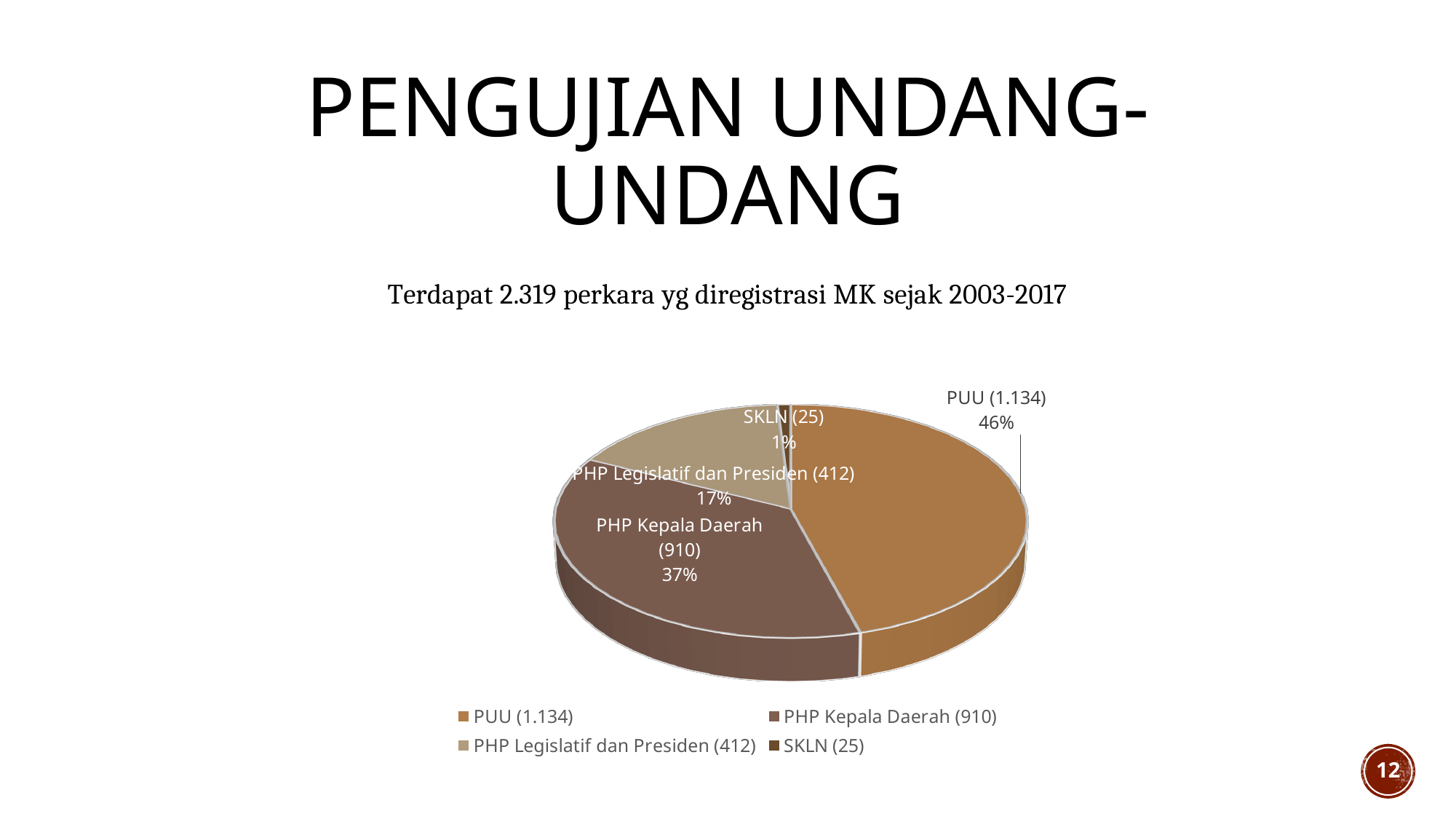
What is the difference in percentage points between the PUU (1.134) share and the PHP Kepala Daerah (910) share? 9% What percentage share does the PHP Legislatif dan Presiden (412) slice have? 17% What percentage share does the SKLN (25) slice have? 1% What kind of chart is shown on the slide? pie chart How many entries does the legend list? 4 How many categories are shown in the pie chart? 4 Which category has the smallest slice of the pie? SKLN (25) What percentage share does the PHP Kepala Daerah (910) slice have? 37% Which is larger, the share for PHP Kepala Daerah (910) or the share for PHP Legislatif dan Presiden (412)? PHP Kepala Daerah (910) Which category has the largest slice of the pie? PUU (1.134) What is the total number of cases stated in the subtitle above the chart? 2.319